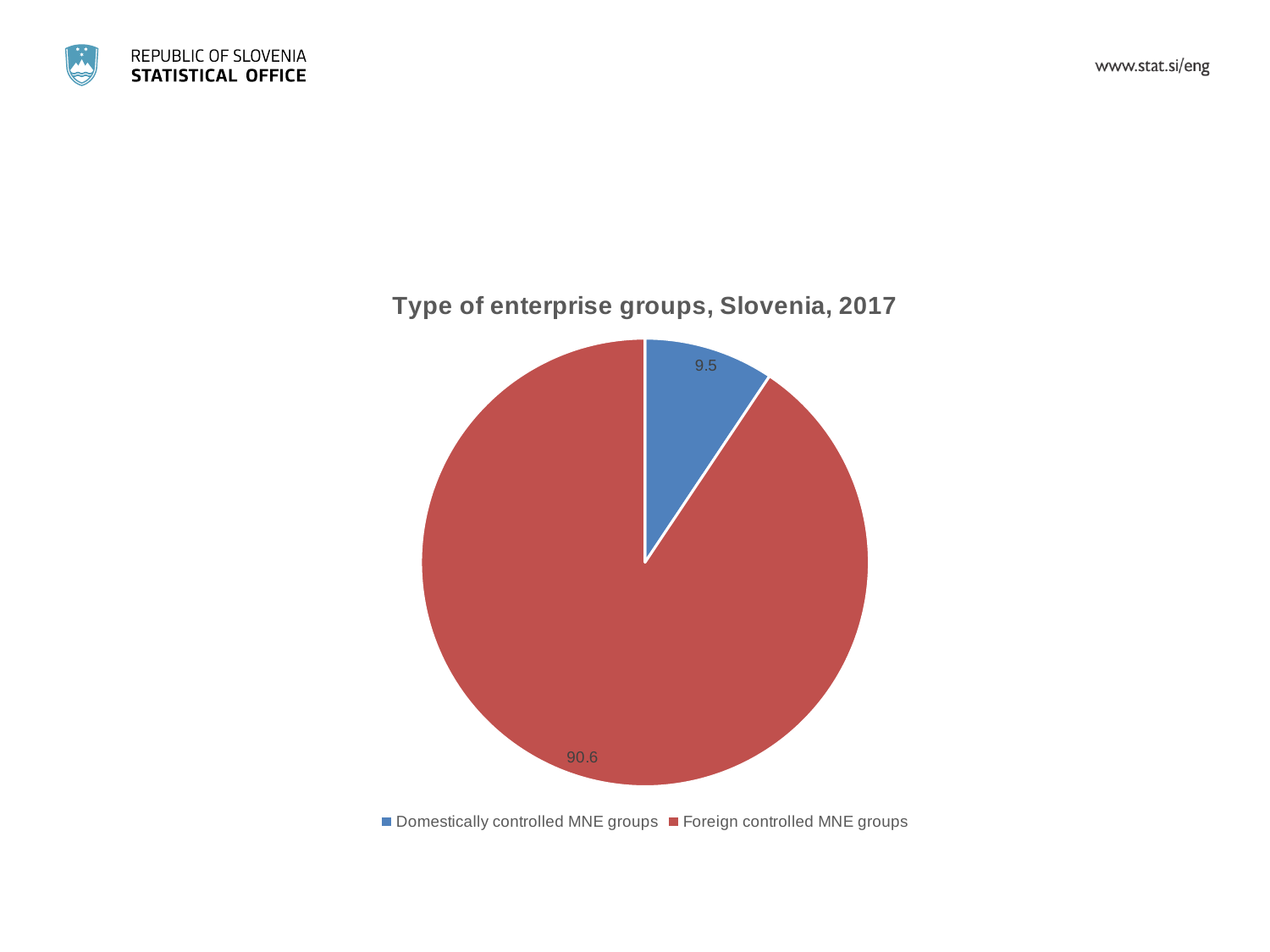
What is the value for Foreign controlled MNE groups? 90.6 What colour is the slice for Foreign controlled MNE groups? red What is the title of the chart? Type of enterprise groups, Slovenia, 2017 Which category has the smallest slice of the pie? Domestically controlled MNE groups How many entries does the legend list? 2 What kind of chart is shown on the slide? pie chart How many categories does the pie chart show? 2 Which category has the largest slice of the pie? Foreign controlled MNE groups What is the difference between the values for Foreign controlled MNE groups and Domestically controlled MNE groups? 81.1 What is the value for Domestically controlled MNE groups? 9.5 Which is larger, the value for Domestically controlled MNE groups or the value for Foreign controlled MNE groups? Foreign controlled MNE groups